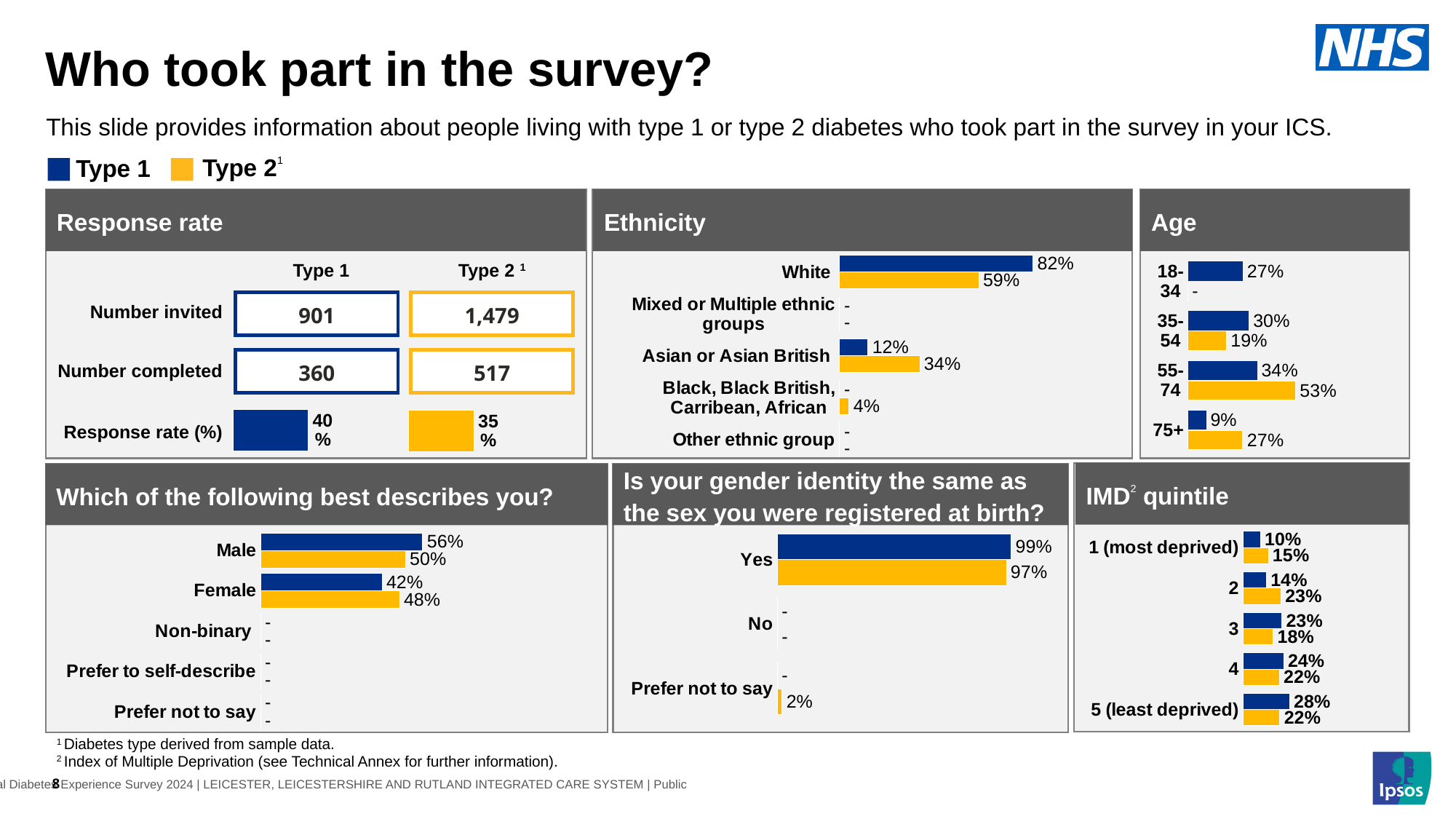
In the Response rate panel, what is the number of Type 2 respondents invited? 1,479 In the gender identity chart, what percentage of Type 2 respondents answered Yes? 97% In the Ethnicity chart, what is the Type 2 value for Asian or Asian British? 34% In the 'Which of the following best describes you?' chart, what is the Type 2 value for Female? 48% In the Age chart, which age group has the lowest Type 1 percentage? 75+ In the Age chart, what is the difference between the Type 1 and Type 2 values for the 75+ group? 18% In the IMD quintile chart, what is the Type 2 value for quintile 2? 23% In the 'Which of the following best describes you?' chart, which is larger for Type 1: Male or Female? Male What type of chart is the Ethnicity chart? Bar chart In the IMD quintile chart, which quintile has the highest Type 1 percentage? 5 (least deprived) In the Ethnicity chart, what percentage of Type 1 respondents are White? 82% In the Age chart, what percentage of Type 2 respondents are aged 55-74? 53%